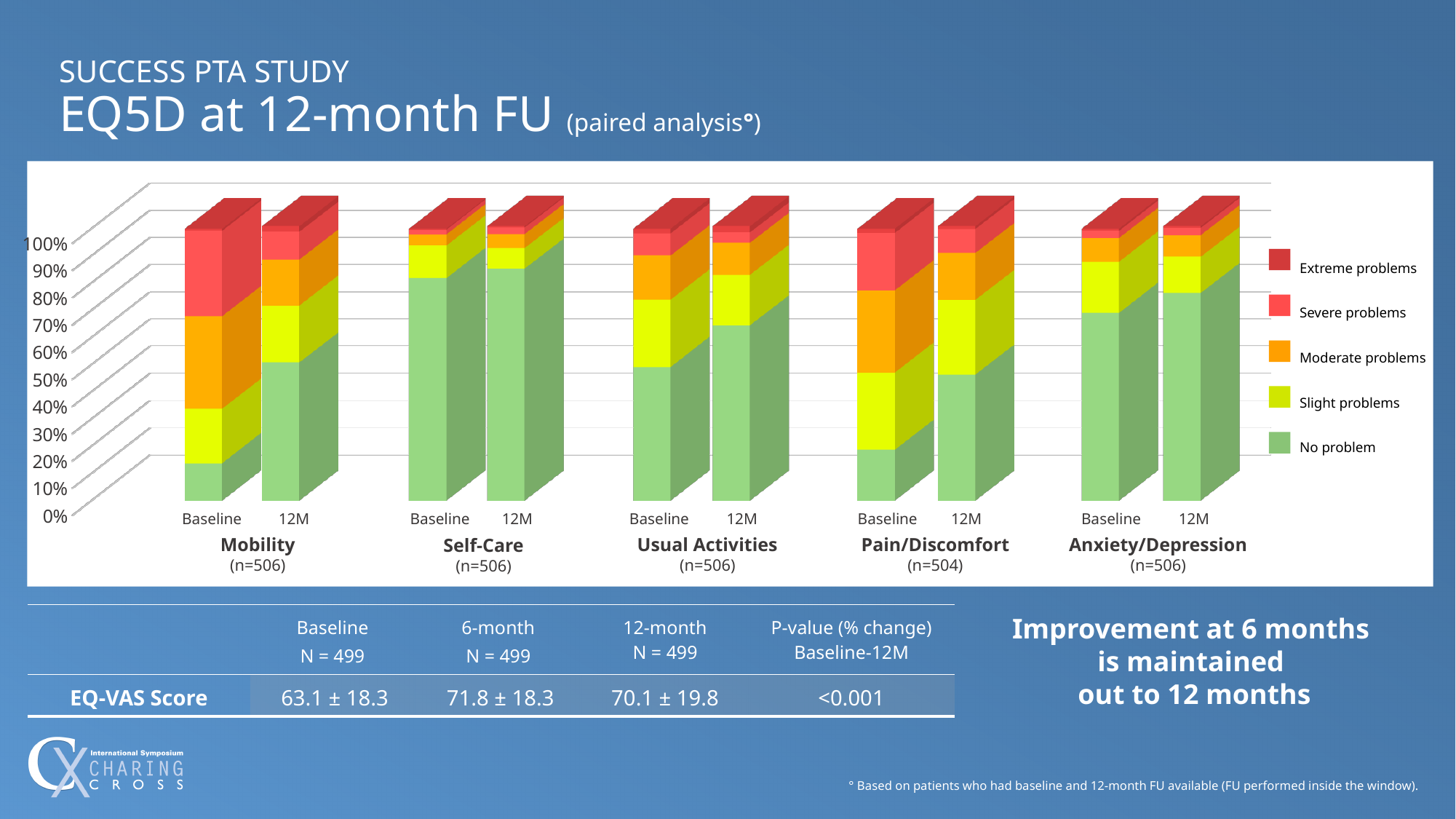
Is the 'No problem' share for Usual Activities at 12M greater or less than 60%? greater Which legend entry is shown in dark red at the top of each stacked bar? Extreme problems For Mobility, which bar has the larger 'No problem' share: Baseline or 12M? 12M How many EQ5D dimensions (category groups) are shown on the x axis of the chart? 5 What is the sample size (n) shown under the Pain/Discomfort category? n=504 How many series does the chart legend list? 5 What kind of chart is shown on the slide? stacked bar chart Is the 'No problem' share for Self-Care at Baseline greater or less than 80%? greater For Pain/Discomfort, does the 'No problem' share rise or fall from Baseline to 12M? rise Is the 'No problem' share for Pain/Discomfort at Baseline greater or less than 30%? less